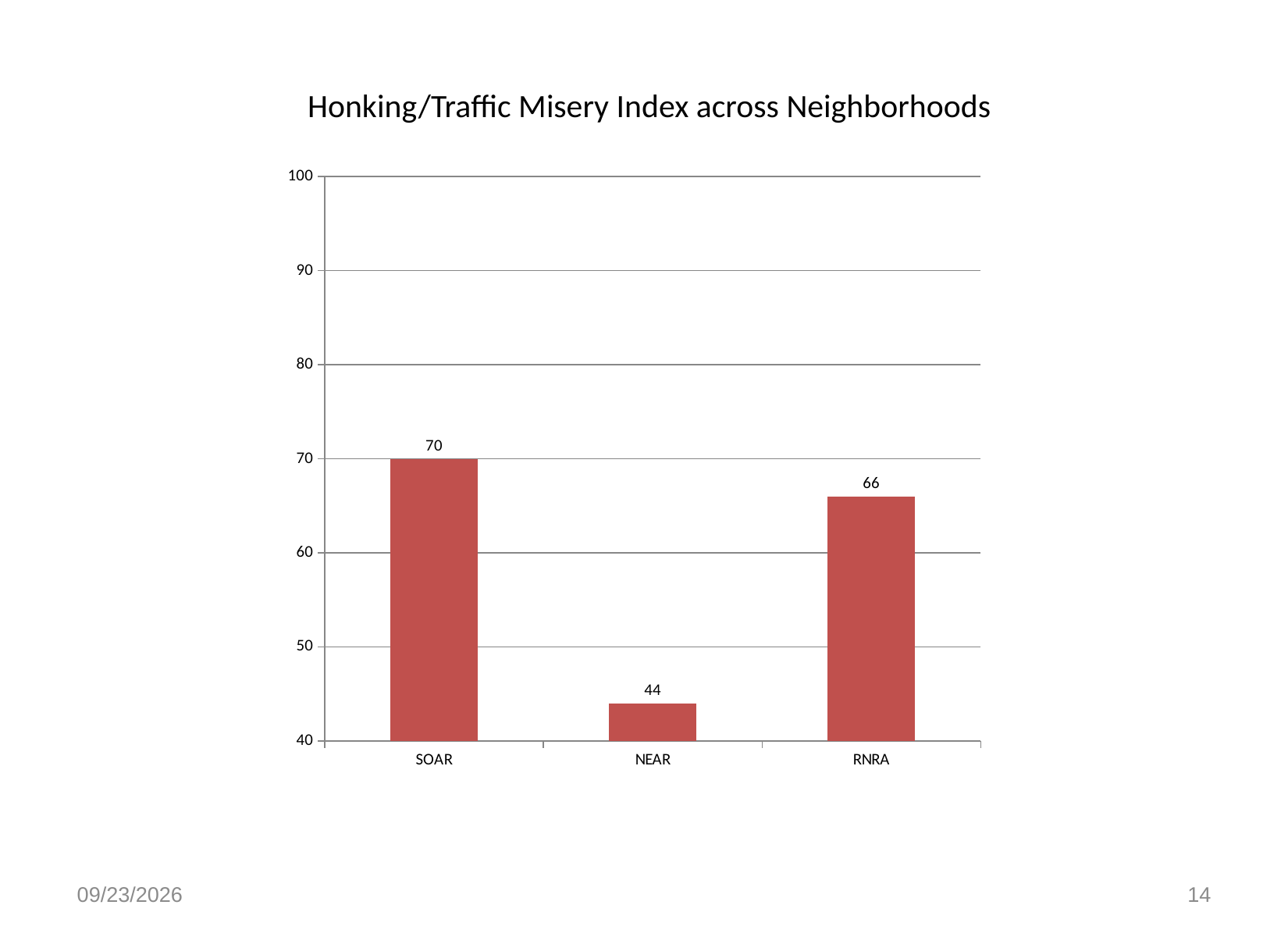
What is the Honking/Traffic Misery Index value for SOAR? 70 What is the Honking/Traffic Misery Index value for NEAR? 44 How many neighborhoods are shown in the chart? 3 What is the difference between the index values for SOAR and NEAR? 26 Is the value for NEAR greater or less than 50? less Which neighborhood has the lowest Honking/Traffic Misery Index? NEAR What is the title of the chart? Honking/Traffic Misery Index across Neighborhoods Which neighborhood has the highest Honking/Traffic Misery Index? SOAR What is the difference between the index values for SOAR and RNRA? 4 Which has a higher Honking/Traffic Misery Index, NEAR or RNRA? RNRA What kind of chart is shown on the slide? bar chart What is the Honking/Traffic Misery Index value for RNRA? 66